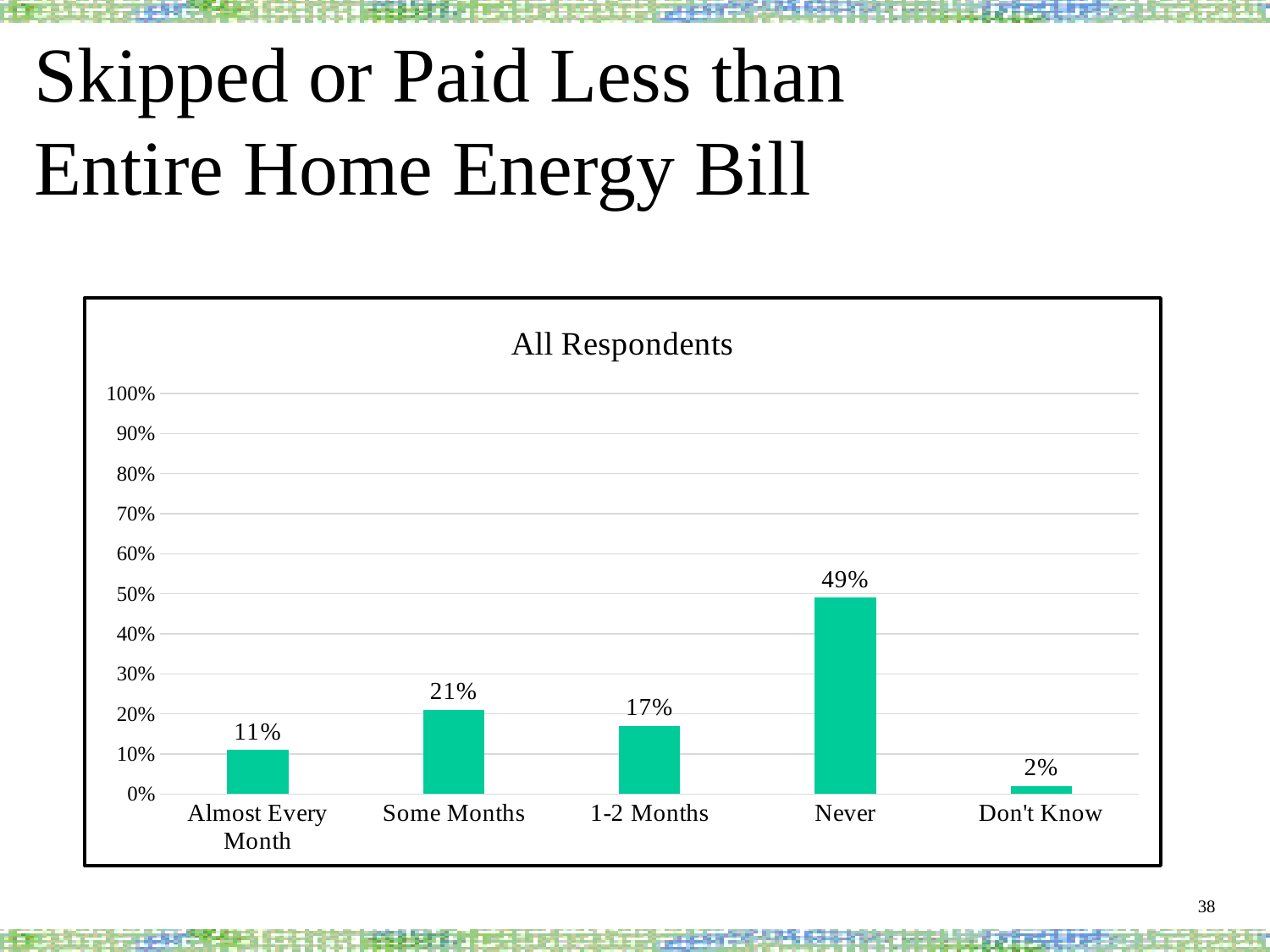
Is the value for Never greater or less than 40%? greater What is the value for Some Months? 21% Which category has the highest value? Never Which is larger, the value for Some Months or the value for 1-2 Months? Some Months What is the value for Don't Know? 2% What is the difference between the values for Never and Some Months? 28% What is the title of the chart? All Respondents What is the value for Almost Every Month? 11% Which category has the lowest value? Don't Know What is the value for Never? 49% What kind of chart is shown? bar chart How many categories are shown on the x axis? 5